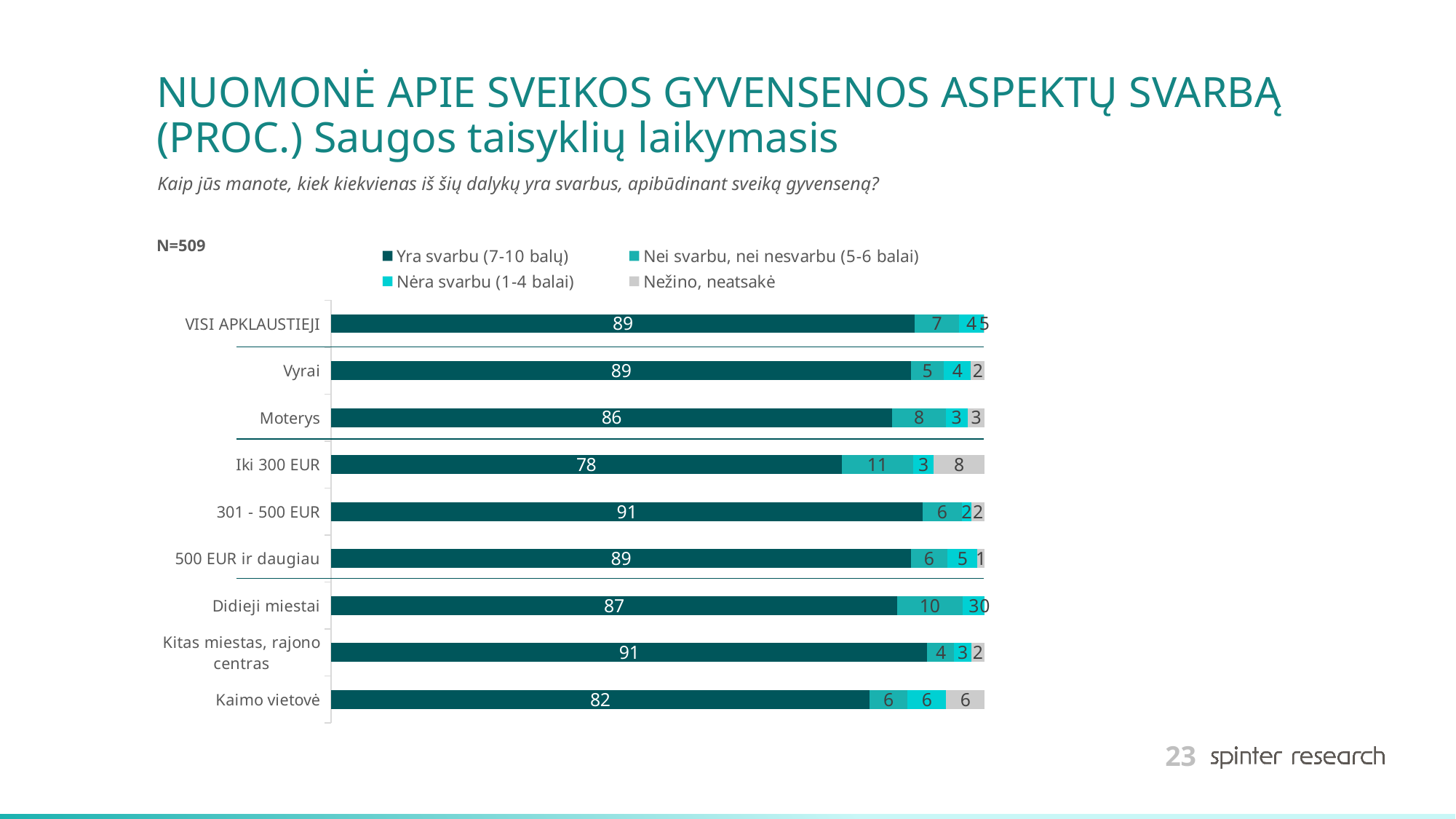
What is the difference between the 'Yra svarbu (7-10 balų)' values for Vyrai and Moterys? 3 What is the 'Nežino, neatsakė' value for the Kaimo vietovė group? 6 How many respondent groups (categories) are shown in the chart? 9 Which group has the lowest 'Yra svarbu (7-10 balų)' value? Iki 300 EUR How many series does the legend list? 4 What percentage of all respondents (VISI APKLAUSTIEJI) rated safety rules compliance as important (Yra svarbu, 7-10 balų)? 89 What is the 'Nei svarbu, nei nesvarbu (5-6 balai)' value for Didieji miestai? 10 Which group has the highest 'Nežino, neatsakė' value? Iki 300 EUR What is the sample size (N) shown on the slide? N=509 What is the 'Yra svarbu (7-10 balų)' value for the Iki 300 EUR group? 78 Which has a larger 'Yra svarbu (7-10 balų)' value: 301 - 500 EUR or Kaimo vietovė? 301 - 500 EUR What kind of chart is shown on the slide? Stacked bar chart